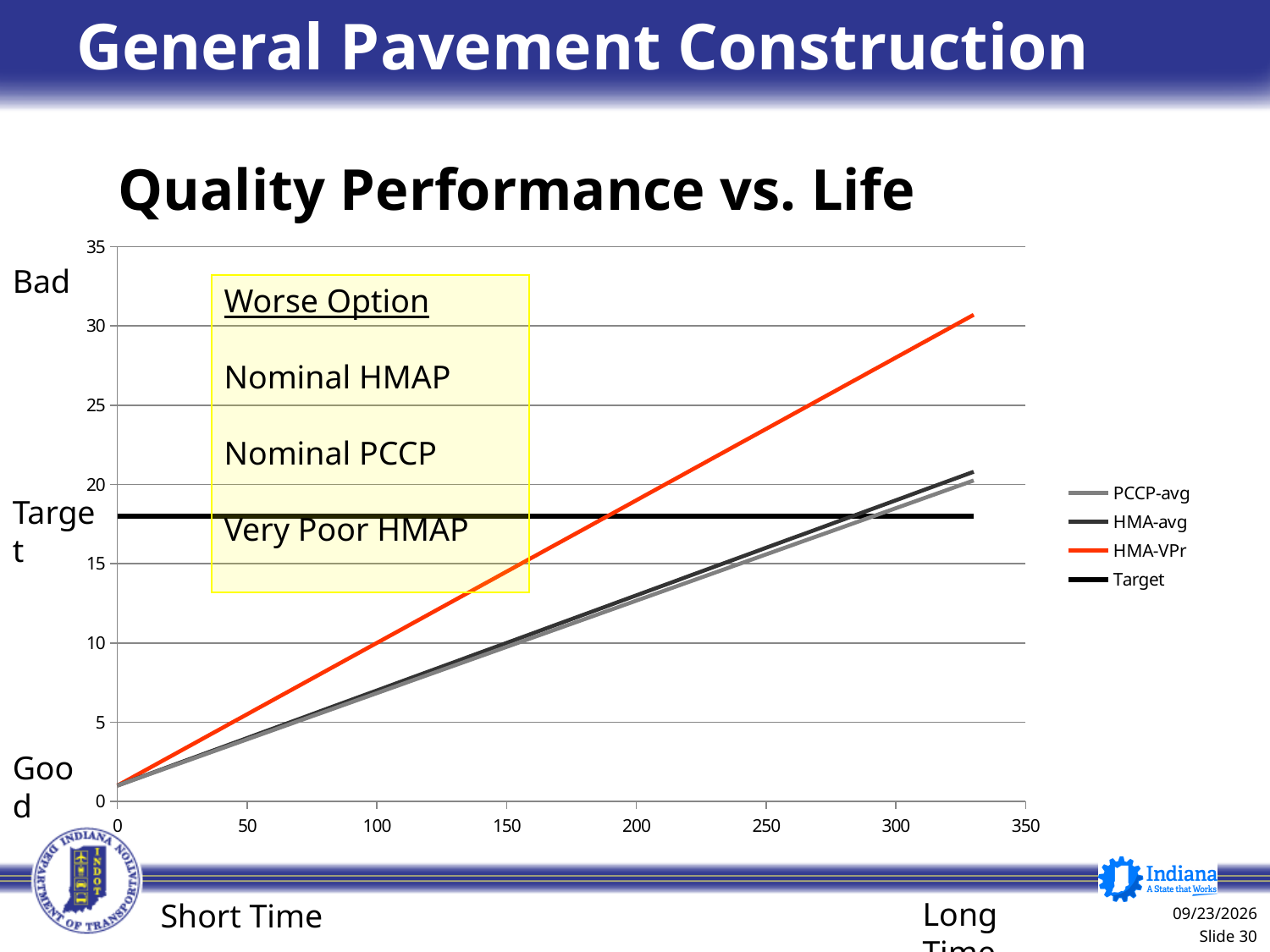
Which series is drawn in red? HMA-VPr At x = 250, which is larger: HMA-VPr or HMA-avg? HMA-VPr How many series does the legend list? 4 Which series reaches the highest value at the right end of the chart? HMA-VPr What is the title of the chart? Quality Performance vs. Life Is the Target line greater or less than 20? less What kind of chart is shown on the slide? line chart Does the Target line rise, fall, or stay flat across the x axis? stays flat Is the value of the PCCP-avg line at x = 300 greater or less than 15? greater Does the HMA-VPr line rise or fall as the x axis increases? rises Is the value of the HMA-avg line at x = 100 greater or less than 10? less